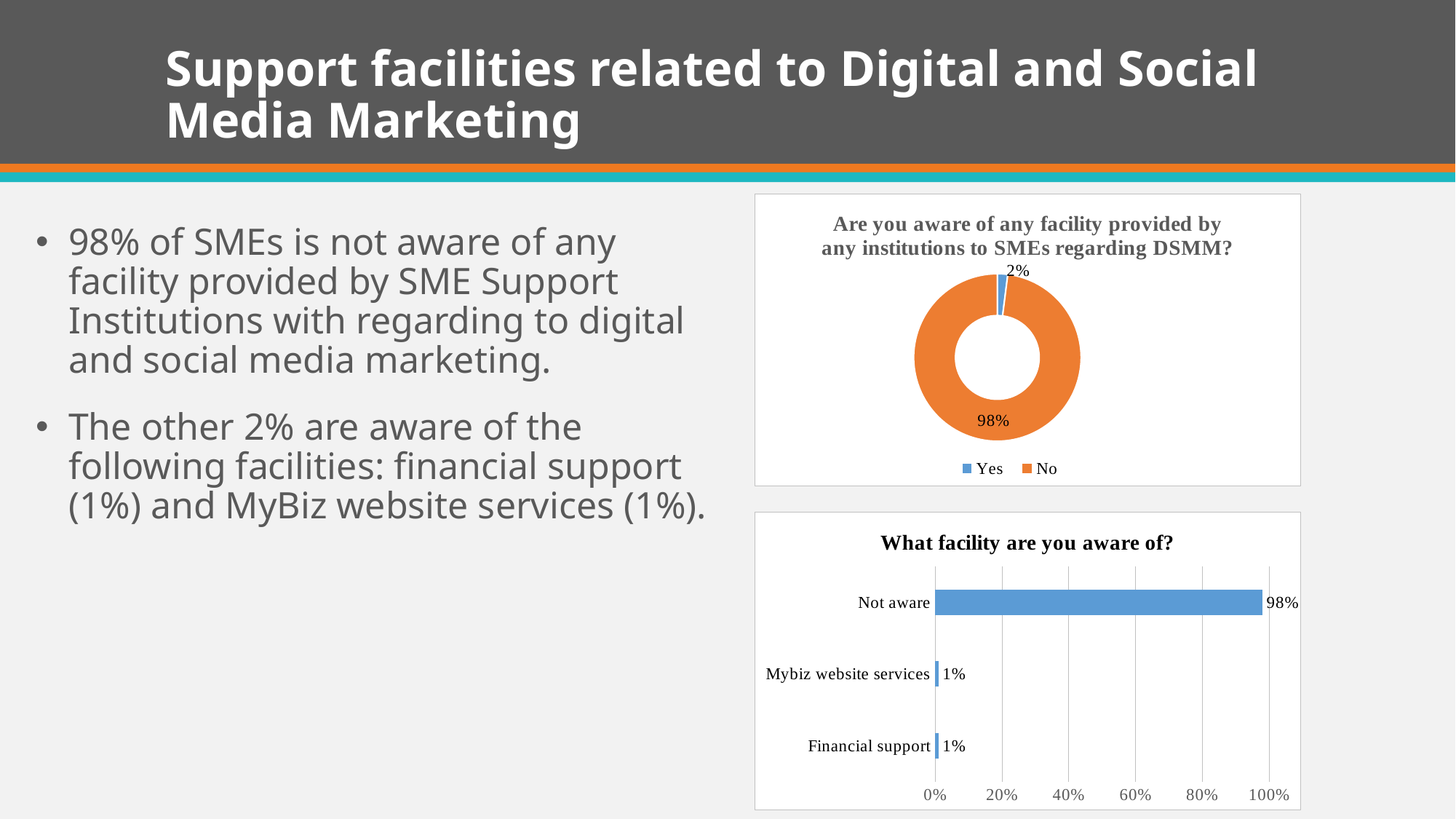
How many categories are shown in the chart titled "What facility are you aware of?"? 3 What kind of chart is the top chart on the right of the slide? Doughnut chart In the top chart, which response has the larger share, Yes or No? No In the chart titled "What facility are you aware of?", which category has the highest value? Not aware In the chart titled "What facility are you aware of?", what is the value for Mybiz website services? 1% In the chart titled "What facility are you aware of?", what is the value for Not aware? 98% What kind of chart is the bottom chart on the right of the slide? Bar chart In the chart titled "Are you aware of any facility provided by any institutions to SMEs regarding DSMM?", what percentage answered Yes? 2% How many entries does the legend of the top chart list? 2 In the chart titled "What facility are you aware of?", what is the value for Financial support? 1% In the top chart, what is the difference between the No share and the Yes share? 96% In the chart titled "Are you aware of any facility provided by any institutions to SMEs regarding DSMM?", what percentage answered No? 98%